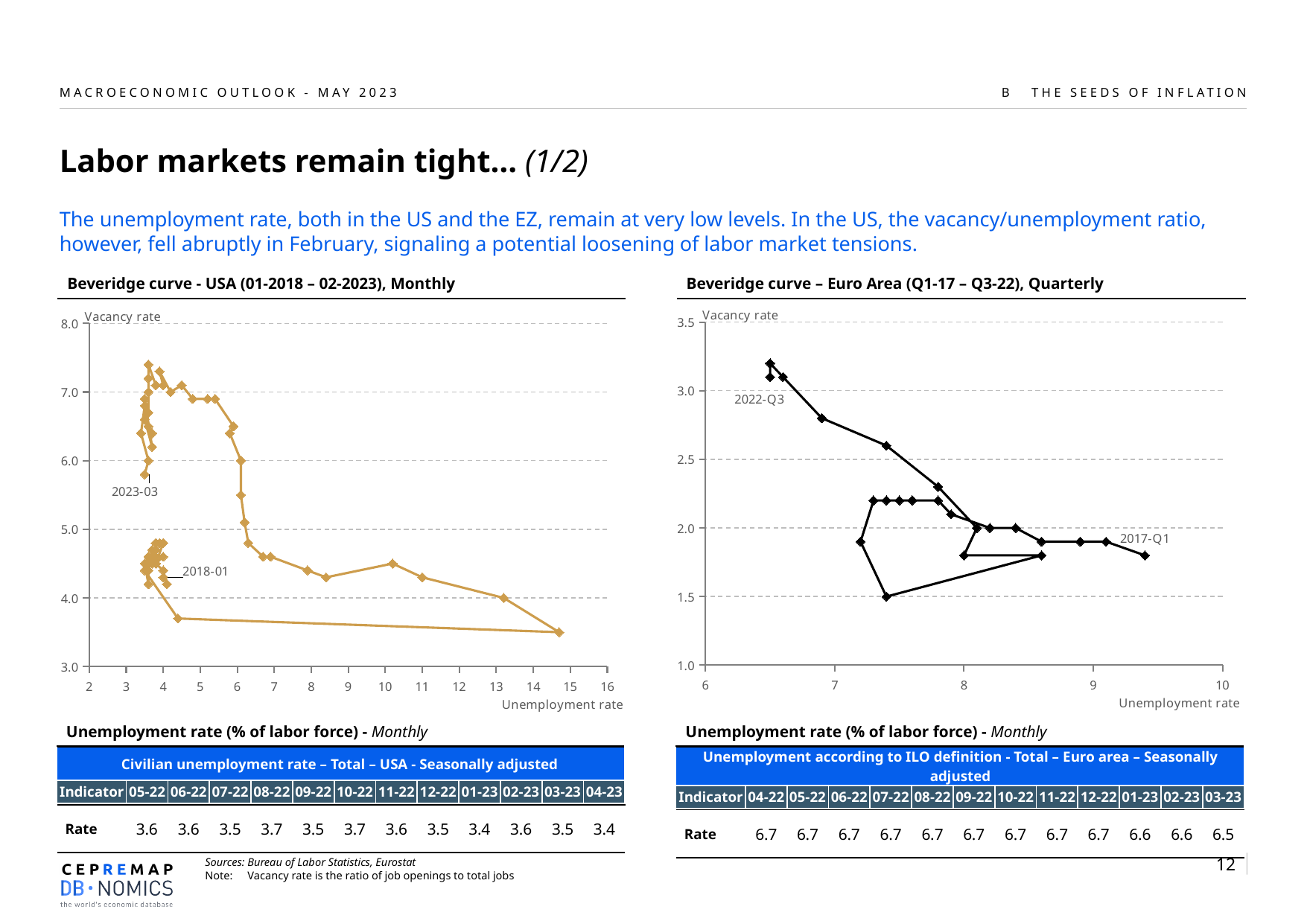
In the Beveridge curve – Euro Area chart, is the vacancy rate for the point labelled 2017-Q1 greater or less than 2.0? less What is the title of the chart on the left of the slide? Beveridge curve - USA (01-2018 – 02-2023), Monthly In the Beveridge curve – Euro Area chart, which labelled point has the higher unemployment rate, 2022-Q3 or 2017-Q1? 2017-Q1 In the Beveridge curve - USA chart, is the vacancy rate for the point labelled 2023-03 greater or less than 5.0? greater In the Beveridge curve – Euro Area chart, is the unemployment rate for the point labelled 2017-Q1 greater or less than 9? greater In the Beveridge curve – Euro Area chart, what variable is plotted on the horizontal axis? Unemployment rate What kind of chart is the Beveridge curve - USA chart? line chart In the Beveridge curve - USA chart, which labelled point has the higher vacancy rate, 2023-03 or 2018-01? 2023-03